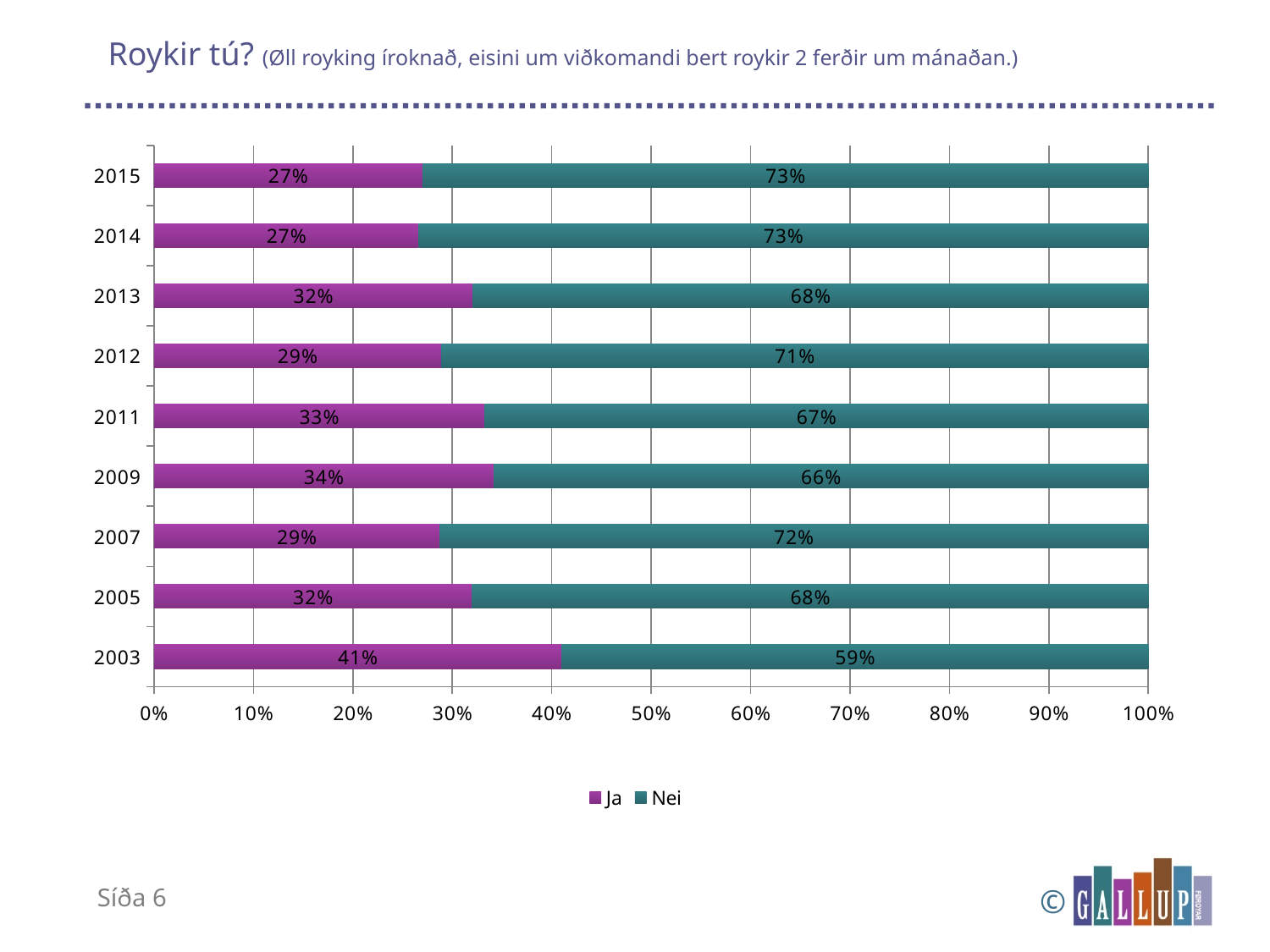
What is the value for Nei in 2011? 67% Which year has the highest value for Ja? 2003 What kind of chart is shown on the slide? Stacked bar chart What is the value for Ja in 2003? 41% Which is larger, the Ja value in 2003 or the Ja value in 2015? 2003 What is the total of the stacked bar for 2012? 100% Which year has the lowest value for Nei? 2003 What is the difference between the Nei value and the Ja value in 2009? 32% What is the value for Ja in 2013? 32% How many series does the legend list? 2 Which colour represents the Nei series in the legend? Teal How many years are shown on the chart? 9